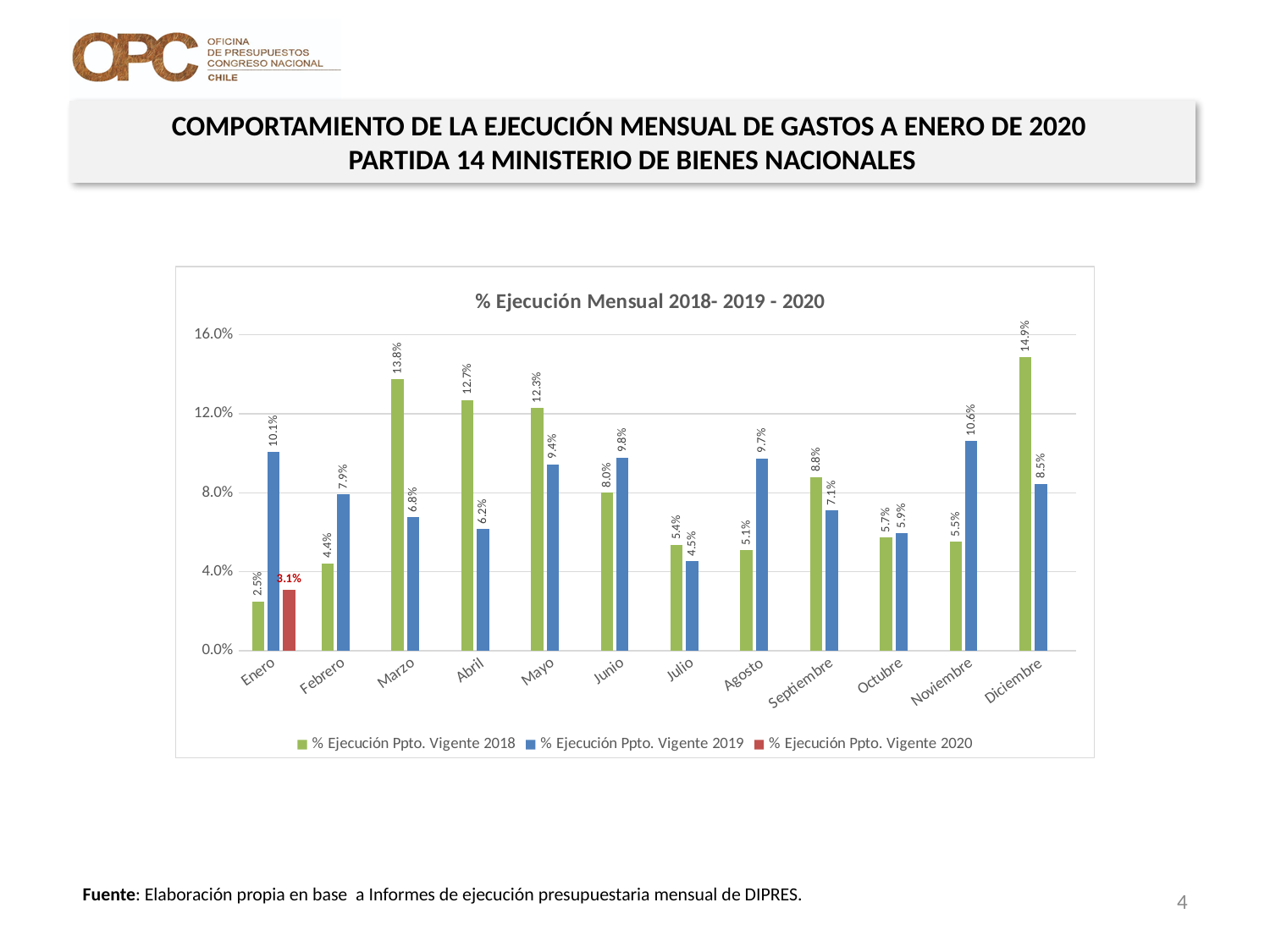
How many series does the legend list? 3 Is the 2018 value for Abril greater or less than 12.0%? greater What is the title of the chart? % Ejecución Mensual 2018- 2019 - 2020 Which month has the highest value in the % Ejecución Ppto. Vigente 2018 series? Diciembre What is the value for Marzo in the % Ejecución Ppto. Vigente 2018 series? 13.8% What is the value for Enero in the % Ejecución Ppto. Vigente 2020 series? 3.1% What is the value for Noviembre in the % Ejecución Ppto. Vigente 2019 series? 10.6% What kind of chart is shown? Bar chart What is the difference between the 2018 and 2019 values for Enero? 7.6% Which month has the lowest value in the % Ejecución Ppto. Vigente 2019 series? Julio How many months are shown on the x axis? 12 Which is larger for Agosto: the 2018 value or the 2019 value? 2019 value (9.7%)